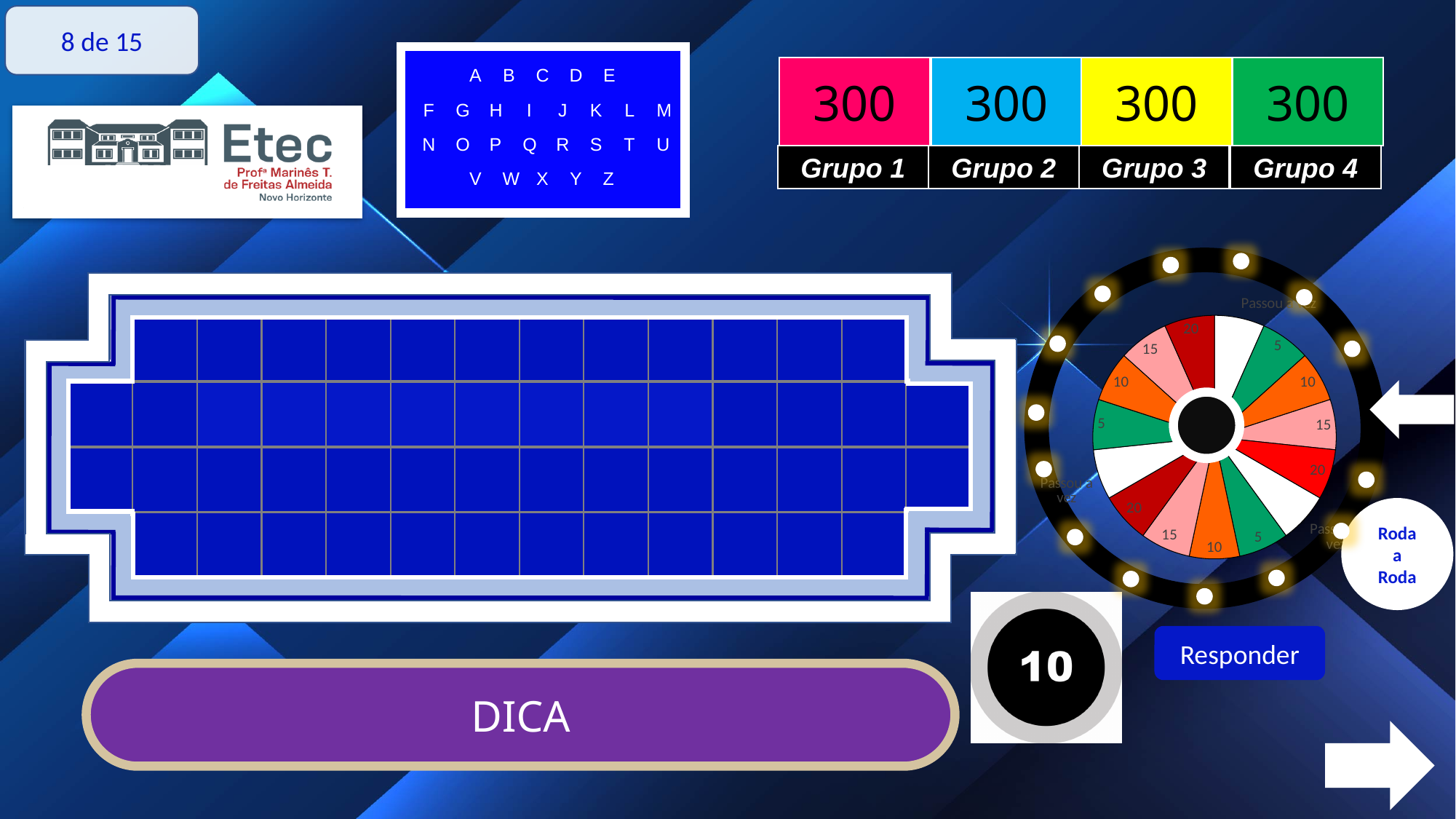
What text appears on the white slices of the wheel? Passou a vez What is the largest number printed on any slice of the wheel? 20 What is the difference between the largest and smallest values printed on the wheel? 15 What kind of chart is the wheel on the right side of the slide? pie chart What colour are the slices of the wheel labelled 20? red What is the smallest number printed on any slice of the wheel? 5 Which is larger, the value on a red slice of the wheel or the value on a green slice? red slice (20) How many different numeric values are printed on the wheel's slices? 4